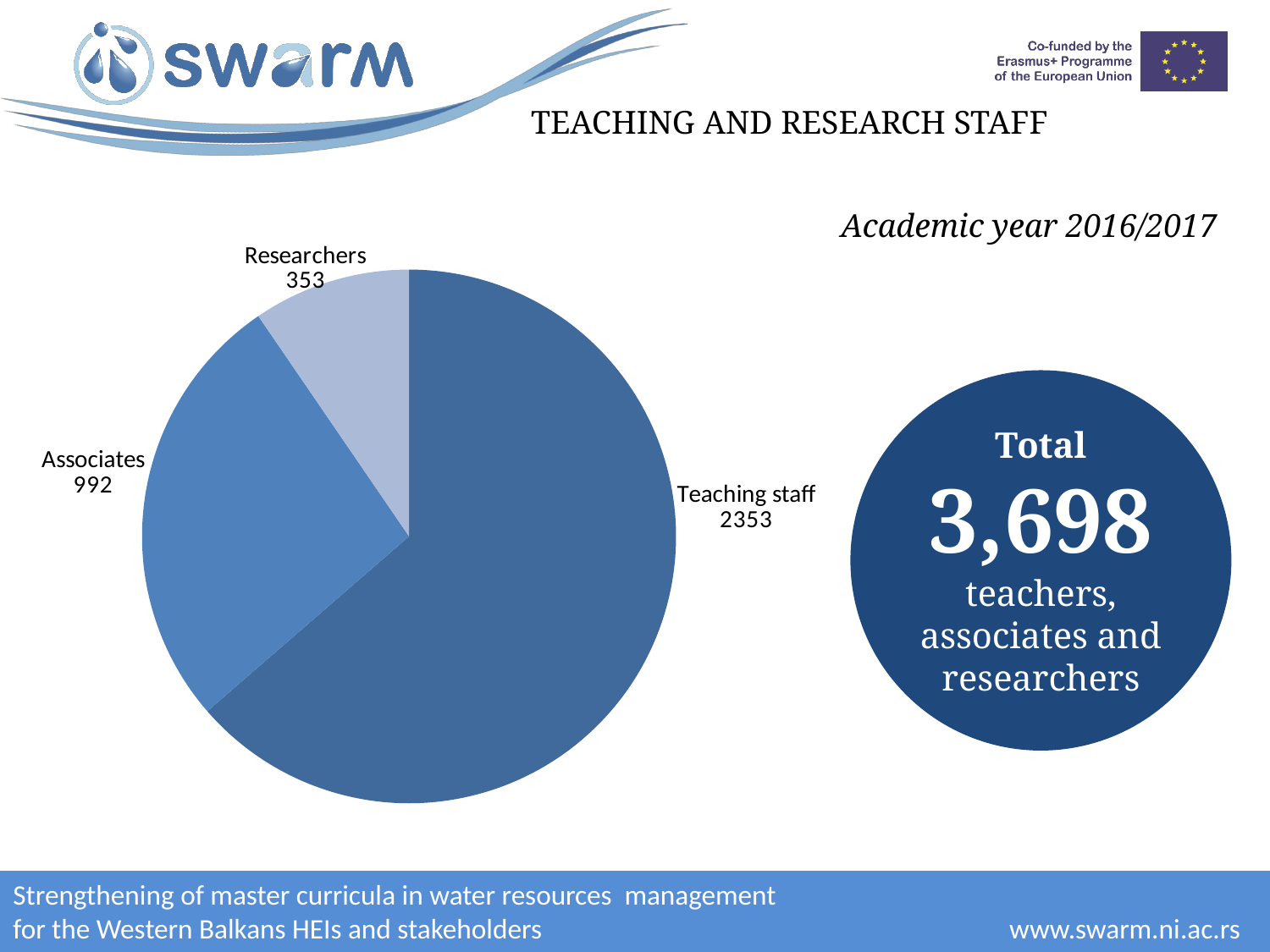
Which is larger, the value for Associates or the value for Researchers? Associates What is the value for Associates in the pie chart? 992 What is the value for Teaching staff in the pie chart? 2353 Which academic year does the pie chart refer to? 2016/2017 What is the difference between the Teaching staff value and the Associates value? 1361 What is the difference between the Associates value and the Researchers value? 639 Which category has the largest slice in the pie chart? Teaching staff What type of chart is shown on the slide? pie chart What is the value for Researchers in the pie chart? 353 How many slices does the pie chart have? 3 Which category has the smallest slice in the pie chart? Researchers What is the total of all three slices in the pie chart? 3,698